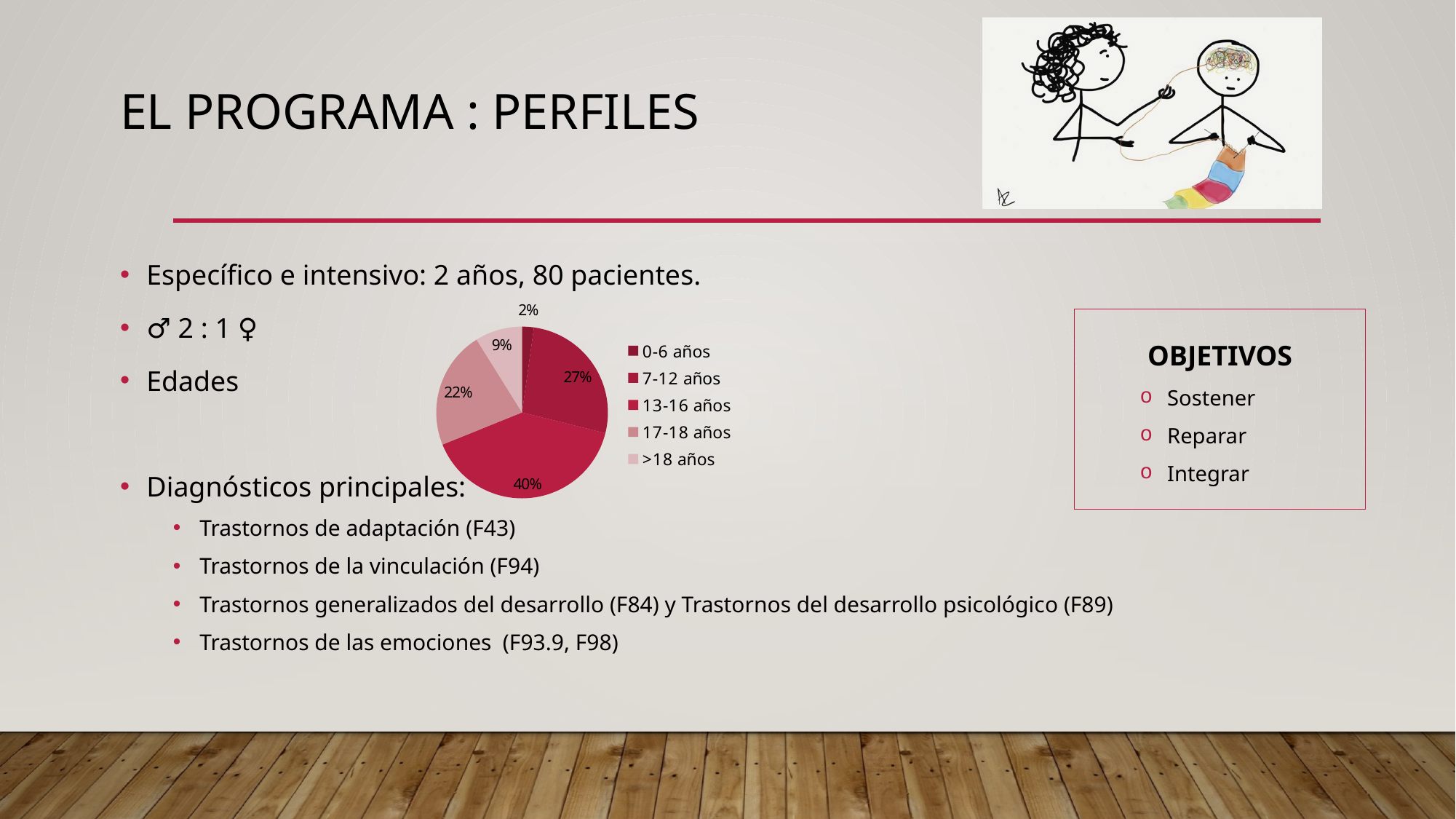
What is the difference in percentage points between the 7-12 años and 0-6 años slices? 25 Which slice is larger, 13-16 años or 17-18 años? 13-16 años Which age group has the smallest share of the pie chart? 0-6 años What is the combined share of the 17-18 años and >18 años slices? 31% How many age groups are listed in the pie chart legend? 5 What percentage of the pie chart corresponds to 7-12 años? 27% What percentage of the pie chart corresponds to 13-16 años? 40% What kind of chart is shown on the slide? pie chart What percentage of the pie chart corresponds to >18 años? 9% What percentage of the pie chart corresponds to 17-18 años? 22% Which age group has the largest share of the pie chart? 13-16 años What percentage of the pie chart corresponds to 0-6 años? 2%